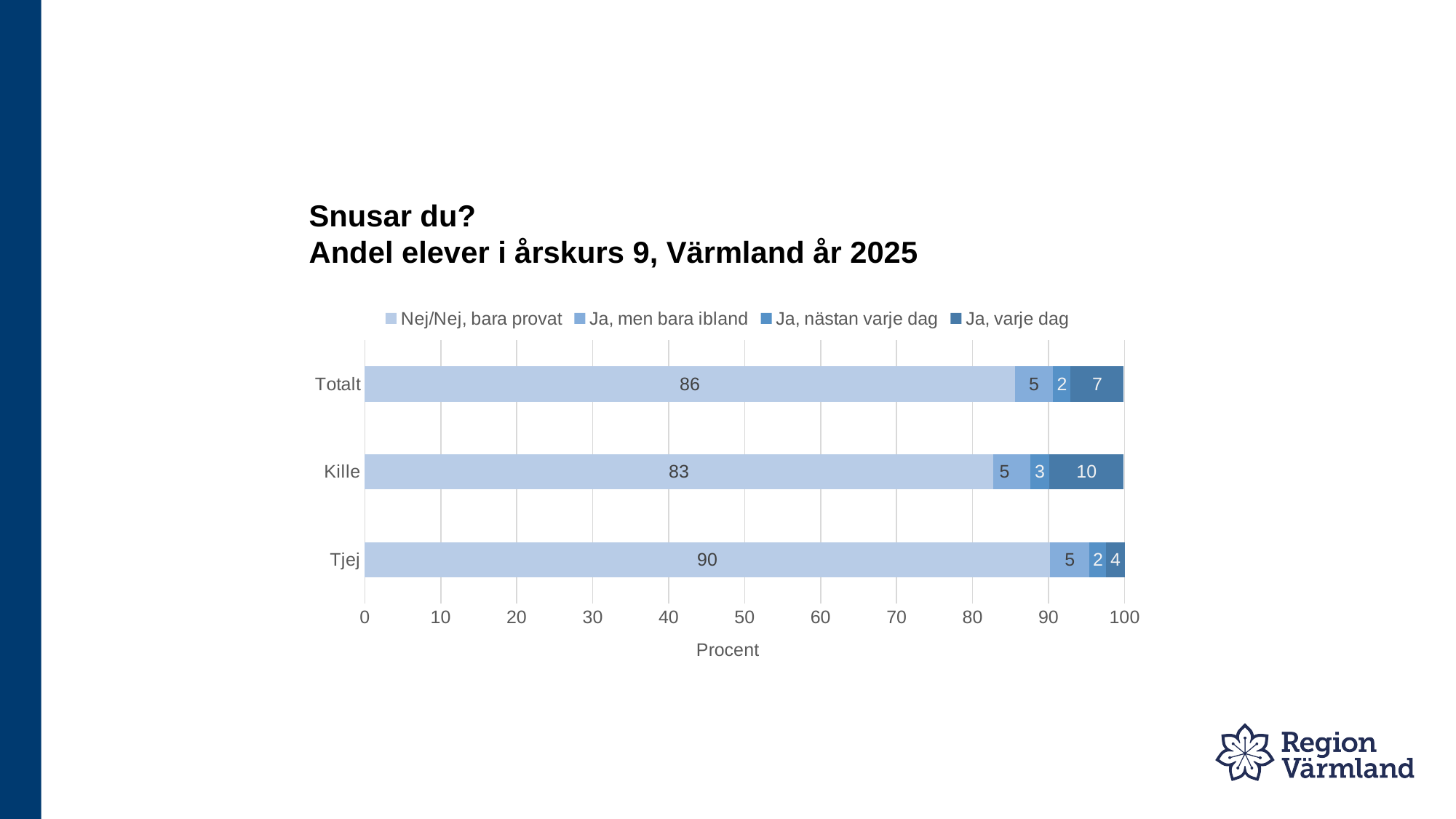
How many series does the legend list? 4 How many categories are shown on the y axis? 3 What is the value for "Ja, nästan varje dag" for Tjej? 2 What is the difference between the "Ja, varje dag" values for Kille and Tjej? 6 What kind of chart is shown? Stacked bar chart What is the total of the stacked bar for Kille? 101 What is the label of the x axis? Procent Which category has the lowest value for "Ja, varje dag"? Tjej Which is larger: the "Nej/Nej, bara provat" value for Kille or for Totalt? Totalt What is the value for "Nej/Nej, bara provat" for Totalt? 86 Which category has the highest value for "Nej/Nej, bara provat"? Tjej What is the value for "Ja, varje dag" for Kille? 10